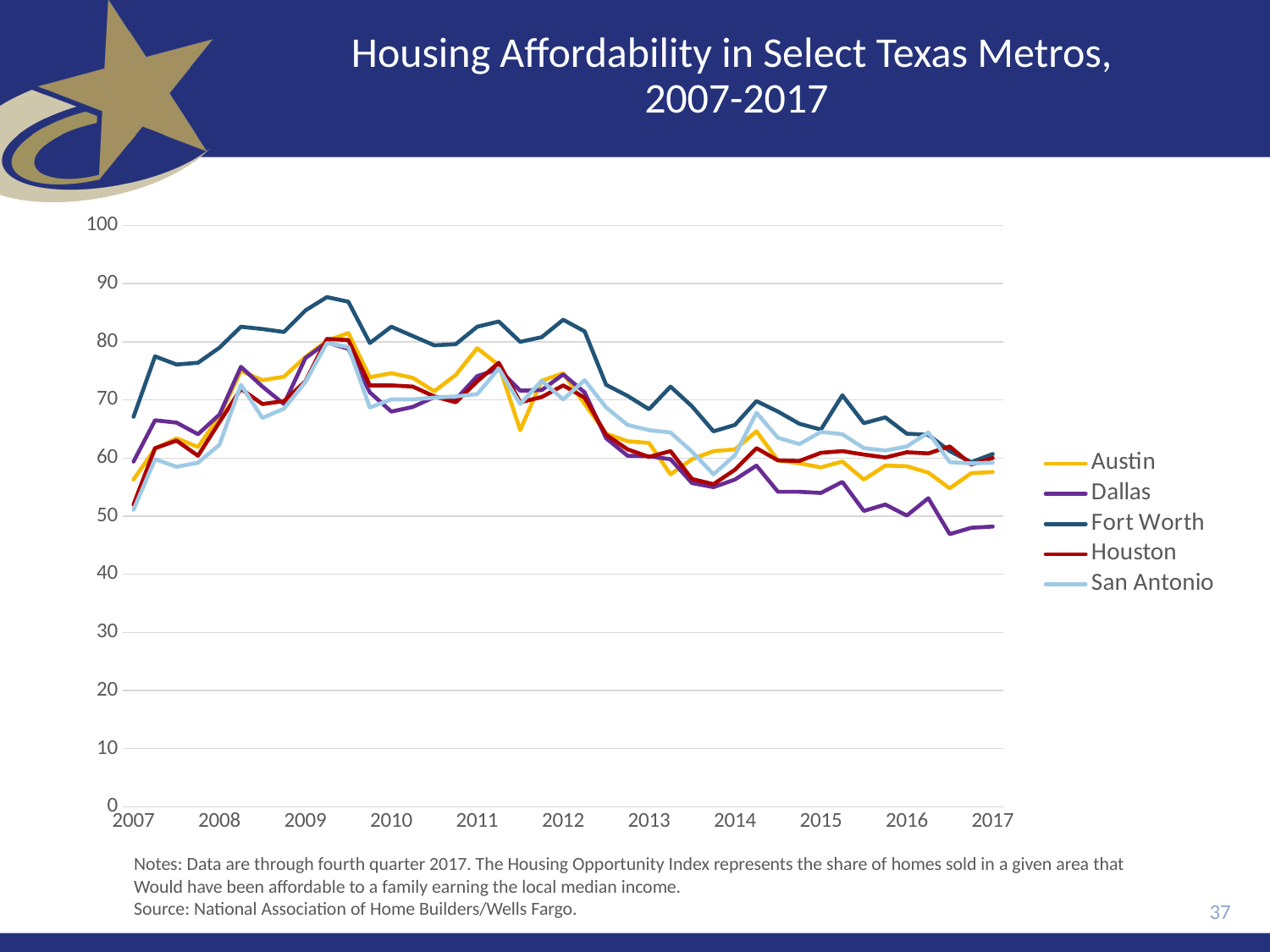
What kind of chart is shown on the slide? line chart Which series reaches the highest value anywhere on the chart? Fort Worth Is the value for Dallas at 2017 greater or less than 50? less Is the peak value for Fort Worth in 2009 greater or less than 80? greater Which metros are listed in the chart's legend? Austin, Dallas, Fort Worth, Houston, San Antonio How many series does the legend list? 5 How many year labels are shown on the x axis? 11 Does the Dallas series generally rise or fall from 2012 to 2017? fall At 2017, which is larger, the value for Austin or the value for Dallas? Austin Which series has the lowest value at 2017? Dallas Is the value for Austin at 2017 greater or less than 50? greater What is the title of the chart? Housing Affordability in Select Texas Metros, 2007-2017